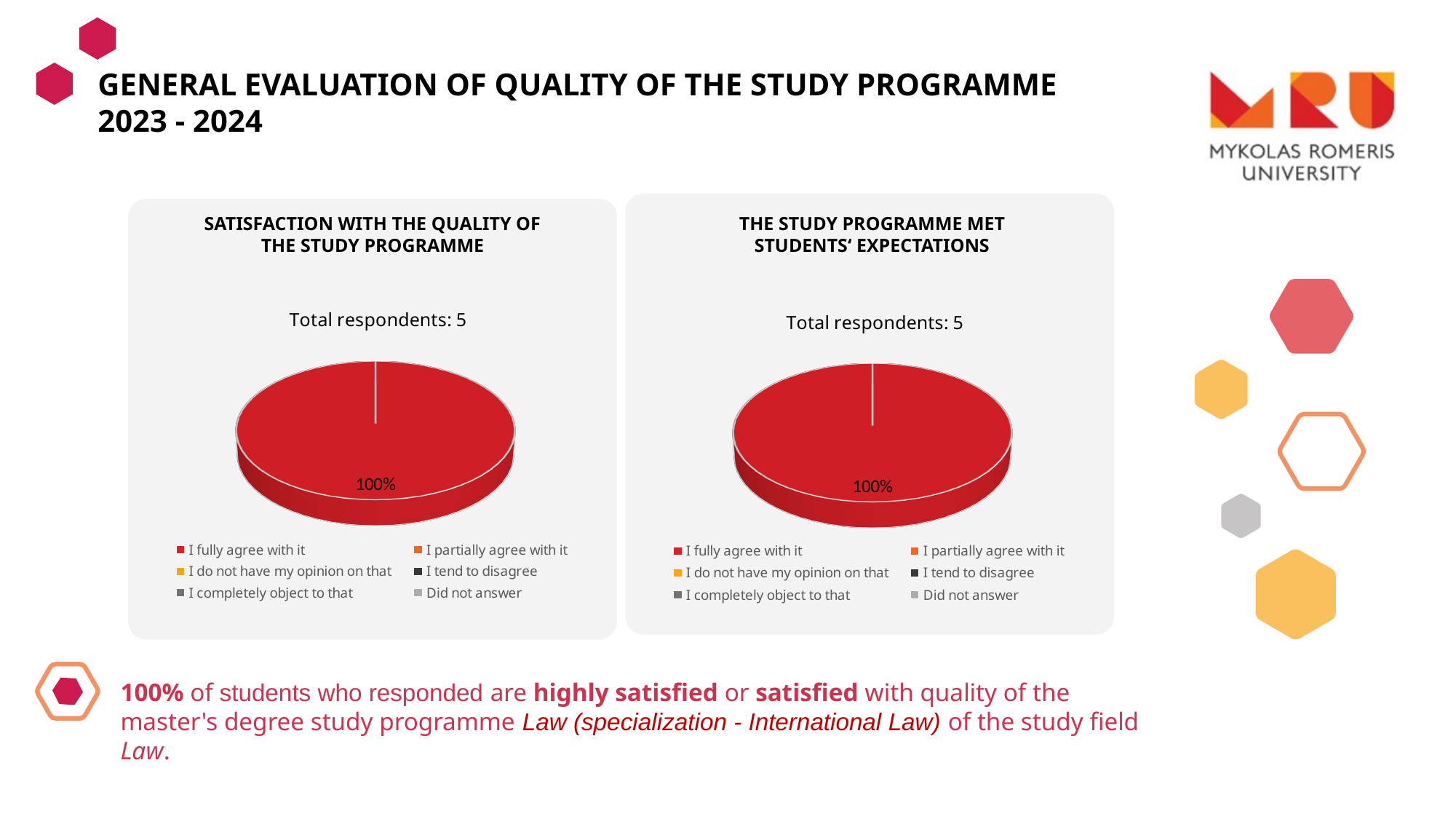
What is the title of the left chart on the slide? Satisfaction with the quality of the study programme What kind of chart is the right chart, "The study programme met students' expectations"? Pie chart How many entries does the legend of the right chart, "The study programme met students' expectations", list? 6 In the chart titled "The study programme met students' expectations", what share of the pie is labelled "I fully agree with it"? 100% In the left chart, "Satisfaction with the quality of the study programme", which legend category makes up the whole pie? I fully agree with it How many entries does the legend of the left chart, "Satisfaction with the quality of the study programme", list? 6 In the right chart, "The study programme met students' expectations", which legend category makes up the whole pie? I fully agree with it How many total respondents are reported for the right chart, "The study programme met students' expectations"? 5 What kind of chart is the left chart, "Satisfaction with the quality of the study programme"? Pie chart In the chart titled "Satisfaction with the quality of the study programme", what share of the pie is labelled "I fully agree with it"? 100% How many total respondents are reported for the left chart, "Satisfaction with the quality of the study programme"? 5 What colour is the "I fully agree with it" slice in the right chart, "The study programme met students' expectations"? Red